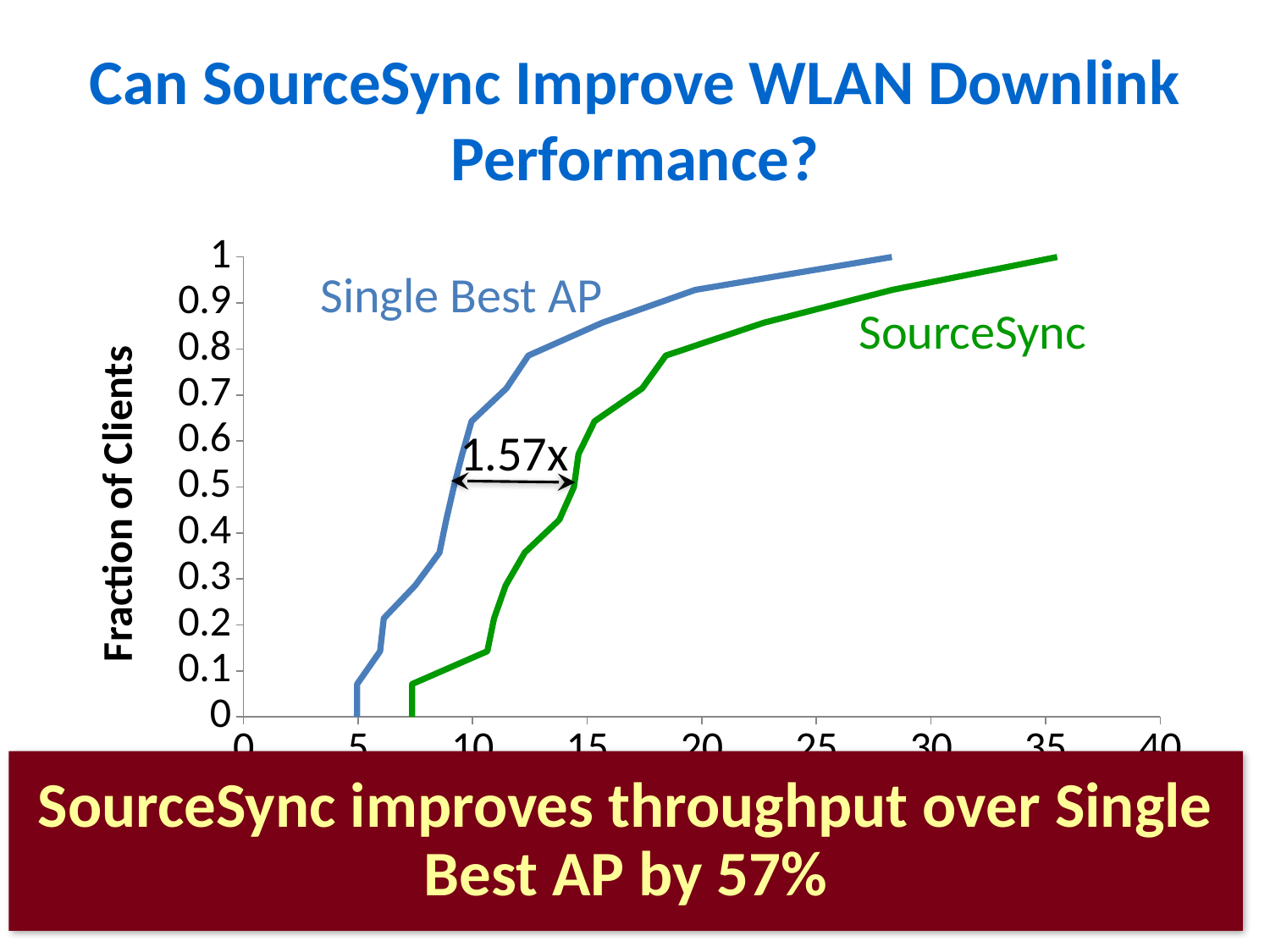
Which series has the curve that starts at a smaller x value, Single Best AP or SourceSync? Single Best AP Do the values of the Single Best AP curve rise or fall as the x axis increases? rise Is the x value at which the Single Best AP curve reaches a fraction of 1 greater or less than 30? less Is the x value at which the Single Best AP curve reaches a fraction of 0.5 greater or less than 10? less What ratio is annotated by the arrow between the two curves at a fraction of 0.5? 1.57x What kind of chart is shown on the slide? line chart Is the x value at which the SourceSync curve reaches a fraction of 1 greater or less than 30? greater How many series are plotted on the chart? 2 What is the label of the y axis? Fraction of Clients Which series reaches a fraction of clients of 1 at a larger x value, Single Best AP or SourceSync? SourceSync What are the names of the two series plotted on the chart? Single Best AP and SourceSync